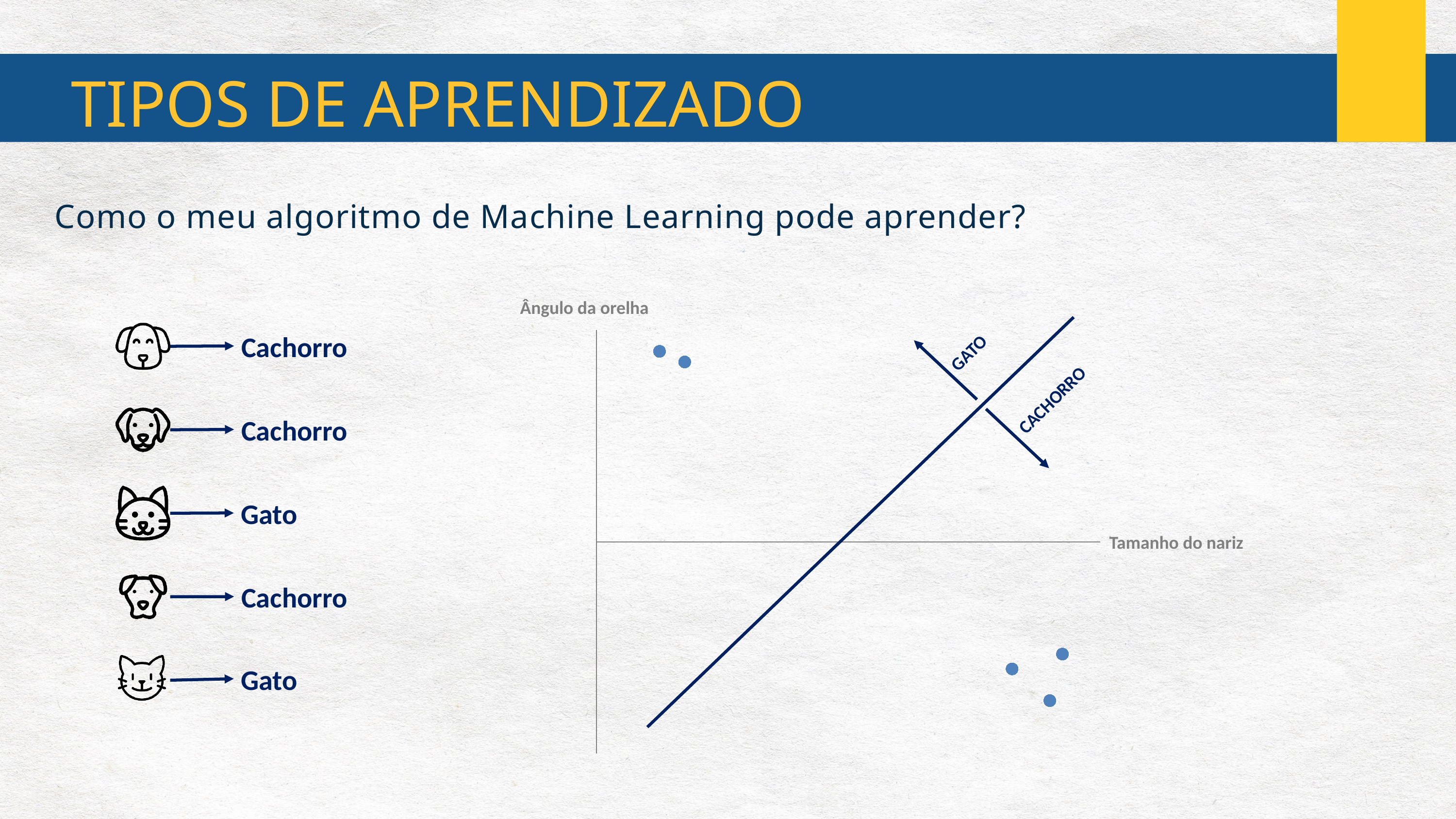
Do the points in the lower-right cluster have a higher or lower 'Ângulo da orelha' than the points in the upper-left cluster? lower Do the points in the upper-left cluster have a larger or smaller 'Tamanho do nariz' than the points in the lower-right cluster? smaller What kind of chart is shown on the right side of the slide? scatter plot Which class label is written on the side of the diagonal line where the upper-left points are located? GATO How many of the labelled examples on the left are 'Cachorro'? 3 Which class label is written on the side of the diagonal line where the lower-right points are located? CACHORRO What is the label of the horizontal axis of the scatter chart? Tamanho do nariz How many labelled examples are listed on the left of the slide? 5 How many data points lie below the diagonal dividing line on the scatter chart? 3 What is the label of the vertical axis of the scatter chart? Ângulo da orelha